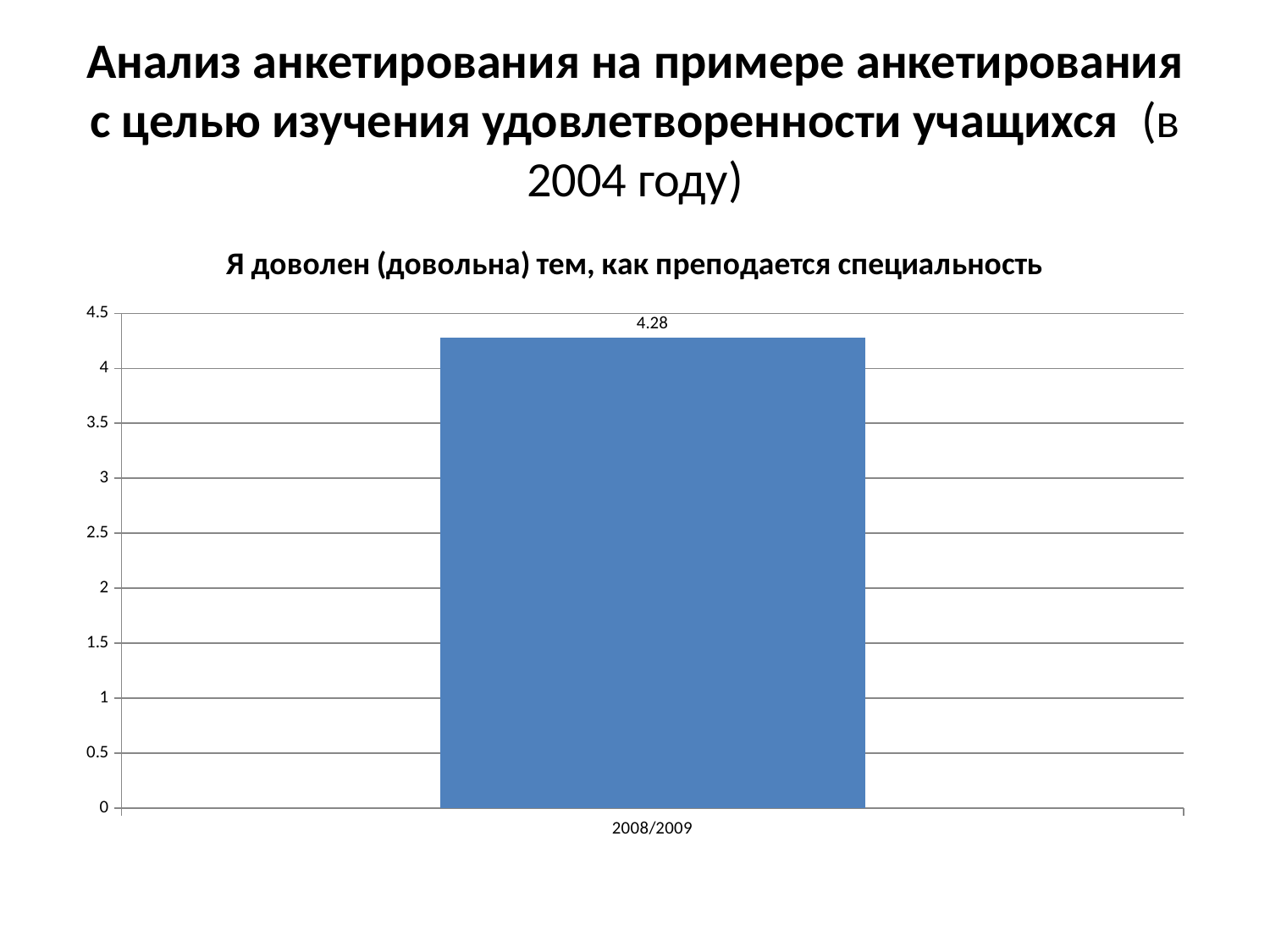
What is the title of the chart? Я доволен (довольна) тем, как преподается специальность Is the value for 2008/2009 greater or less than 4? greater How many bars are plotted in the chart? 1 What kind of chart is shown on the slide? bar chart Is the value for 2008/2009 greater or less than 4.5? less What is the category label shown on the x axis? 2008/2009 What is the value for 2008/2009? 4.28 What is the highest value shown on the y axis? 4.5